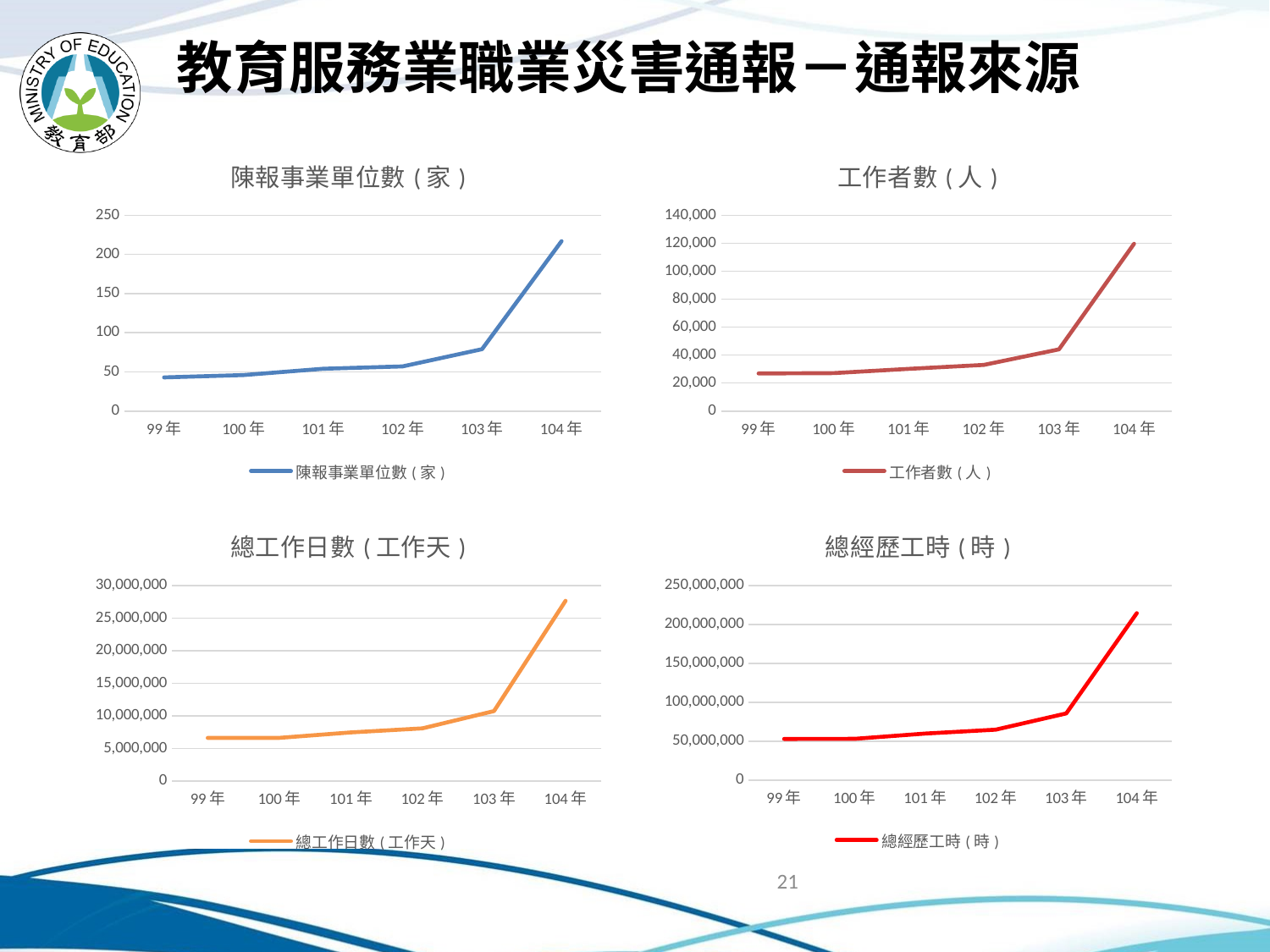
In the 工作者數(人) chart, which year has the lowest value? 99年 What kind of chart is the 總工作日數(工作天) chart? line chart In the 工作者數(人) chart, is the value for 103年 greater or less than 60,000? less In the 總經歷工時(時) chart, is the value for 103年 greater or less than 100,000,000? less How many years are plotted on the x axis of the 總經歷工時(時) chart? 6 In the 陳報事業單位數(家) chart, is the value for 104年 greater or less than 200? greater In the 總工作日數(工作天) chart, which is larger, the value for 103年 or the value for 102年? 103年 In the 陳報事業單位數(家) chart, which year has the highest value? 104年